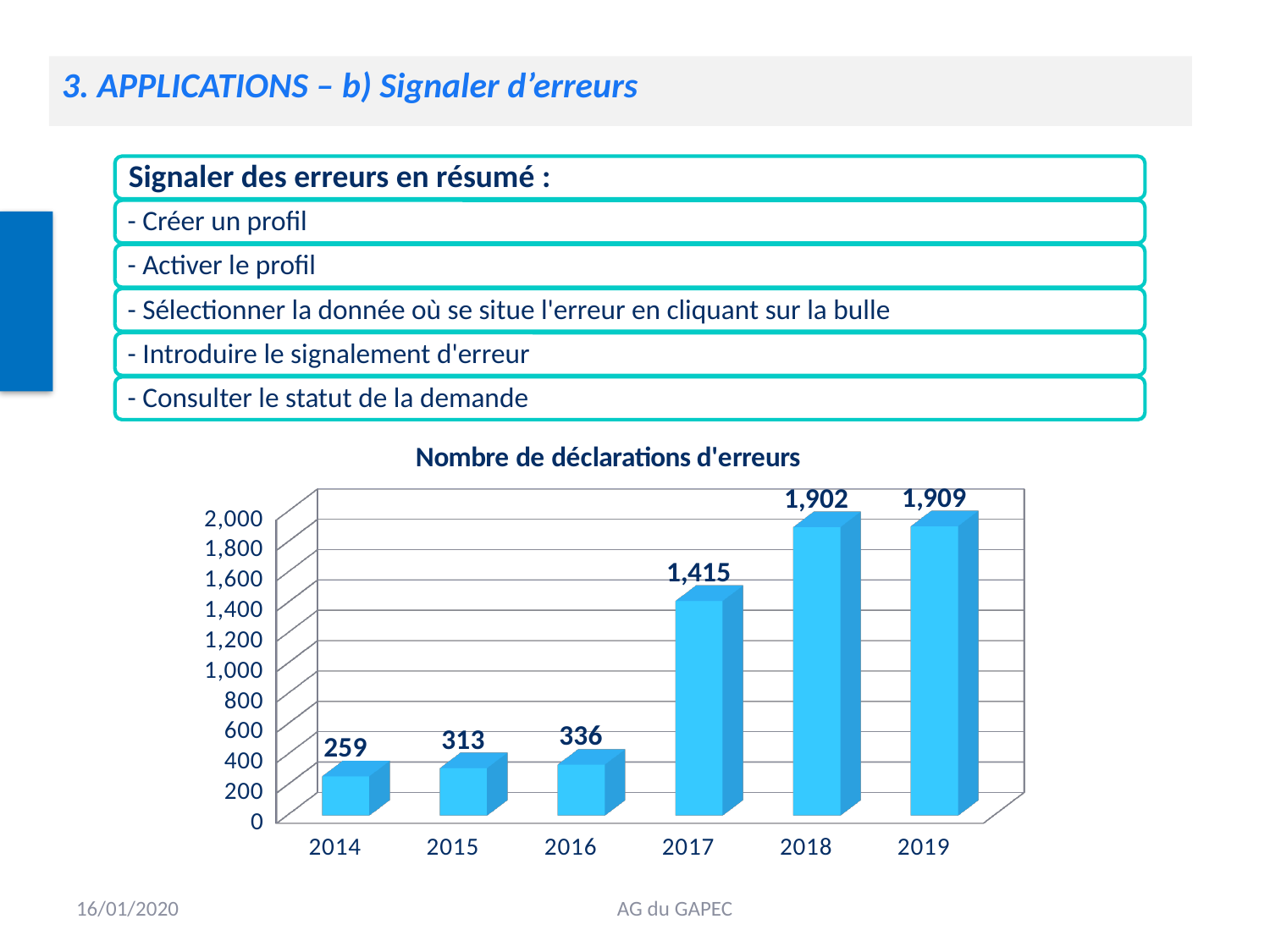
What kind of chart is shown on the slide? bar chart What is the difference between the values for 2016 and 2015? 23 What is the difference between the values for 2018 and 2017? 487 Which year has the highest number of error declarations? 2019 Which year has the lowest number of error declarations? 2014 What is the title of the chart? Nombre de déclarations d'erreurs What is the number of error declarations for 2019? 1,909 How many years are shown on the x axis of the chart? 6 What is the number of error declarations for 2017? 1,415 Is the value for 2017 greater or less than 1,200? greater Which is larger, the value for 2016 or the value for 2015? 2016 What is the number of error declarations for 2014? 259